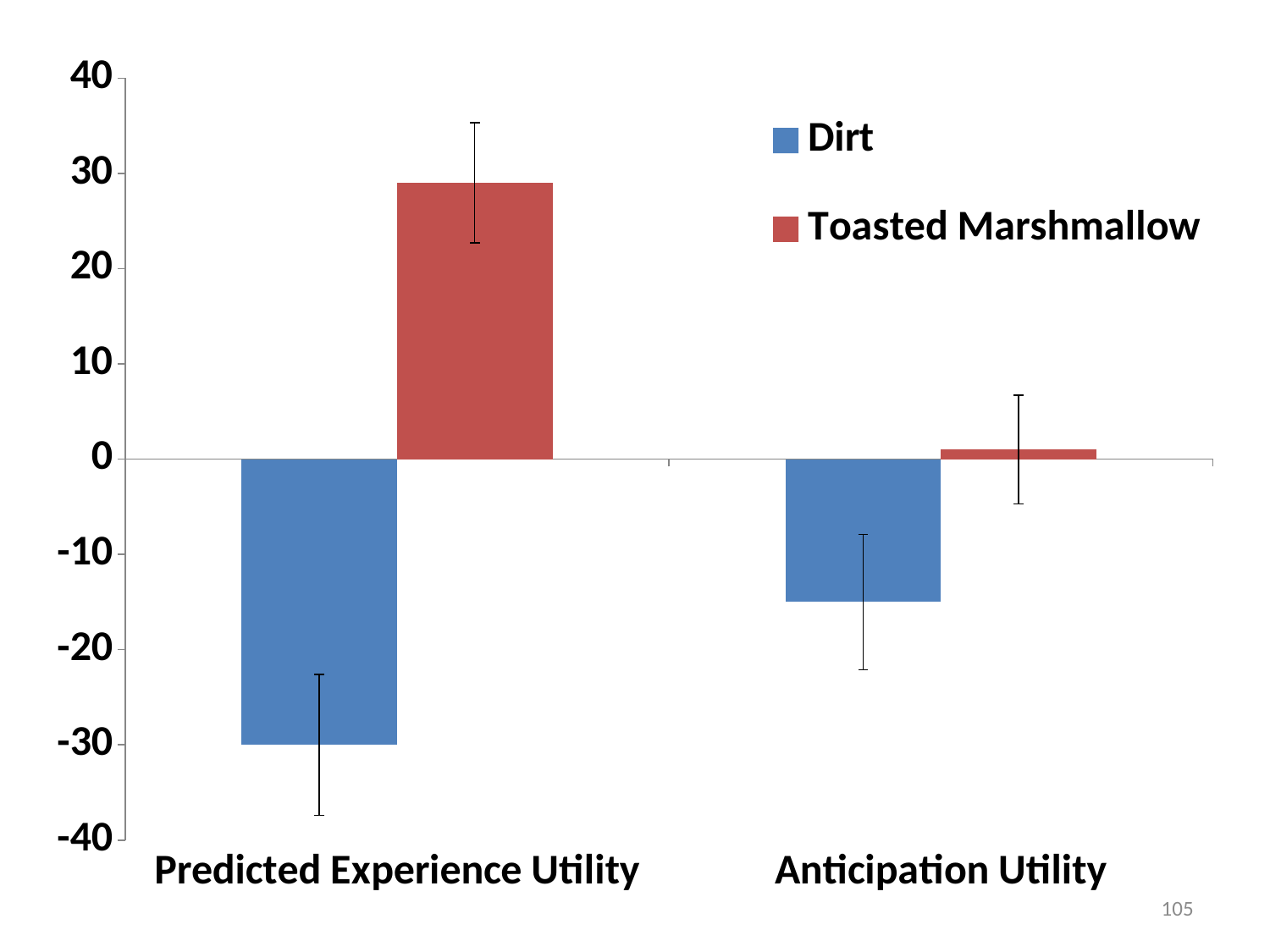
Is the value for Toasted Marshmallow under Anticipation Utility greater or less than 10? less How many series does the legend list? 2 What kind of chart is shown on the slide? bar chart How many categories are shown on the x axis? 2 Which is larger, the Dirt value for Predicted Experience Utility or the Dirt value for Anticipation Utility? Anticipation Utility Is the value for Dirt under Anticipation Utility greater or less than -10? less Is the value for Toasted Marshmallow under Predicted Experience Utility greater or less than 20? greater Which series is shown in blue? Dirt Which bar has the lowest value on the chart? Dirt, Predicted Experience Utility Which bar has the highest value on the chart? Toasted Marshmallow, Predicted Experience Utility Which series is shown in red? Toasted Marshmallow